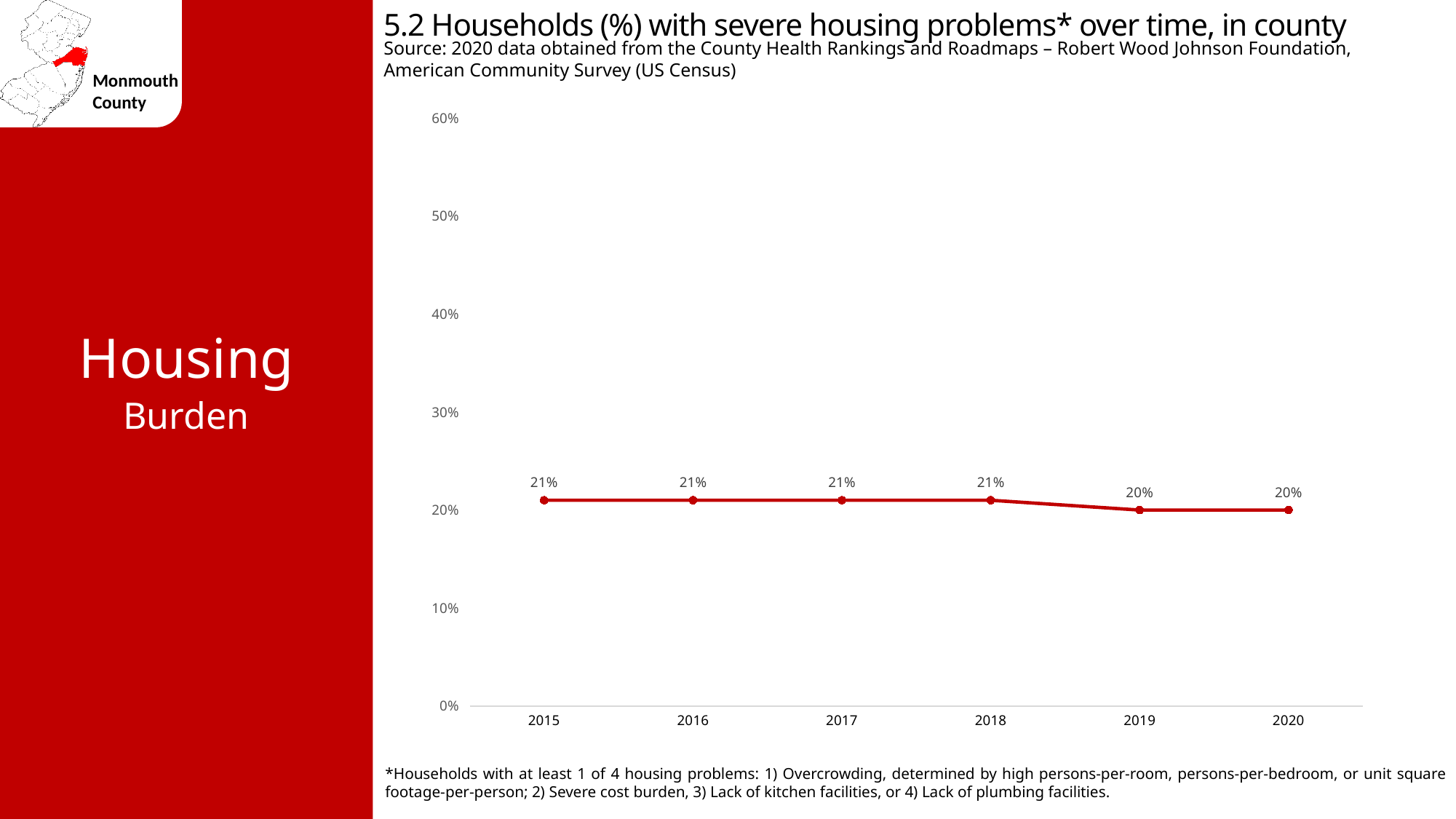
What is the highest value shown on the y axis? 60% How many years are plotted on the x axis? 6 Which is larger, the value for 2018 or the value for 2020? 2018 What is the difference between the 2018 value and the 2019 value? 1% What is the value shown for 2017? 21% What percentage of households had severe housing problems in 2015? 21% Do the values rise or fall from 2015 to 2020? fall What is the value shown for 2019? 20% Is the value for 2016 greater or less than 30%? less What is the first year shown on the x axis? 2015 What kind of chart is shown on the slide? line chart What is the value shown for 2020? 20%